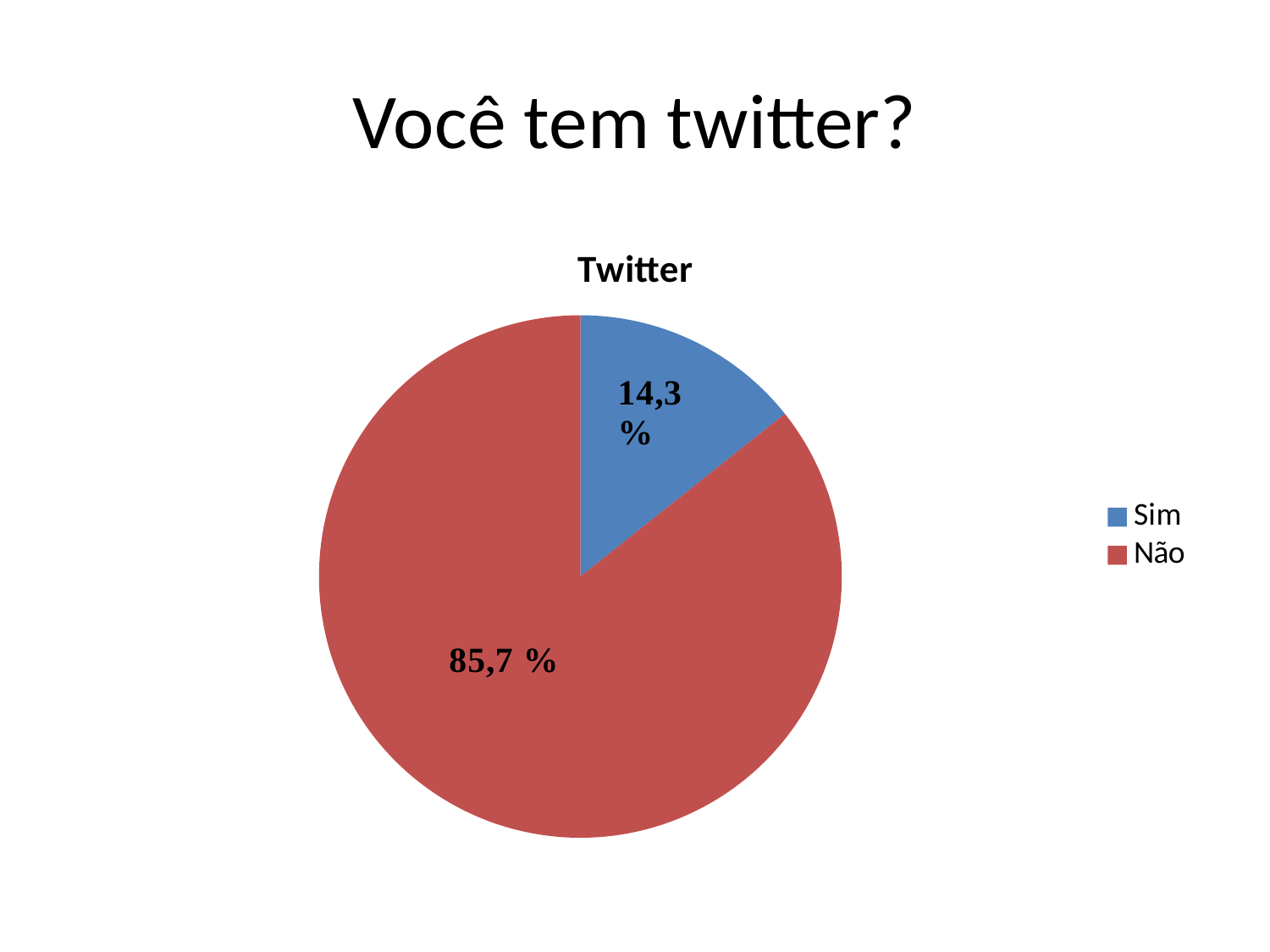
How many categories does the pie chart show? 2 Which category has the largest share of the pie? Não What is the difference in percentage points between the "Não" and "Sim" shares? 71,4 Which category has the smallest share of the pie? Sim What kind of chart is shown on the slide? Pie chart What percentage of respondents answered "Sim"? 14,3 % What is the title of the chart? Twitter Which is larger, the share for "Sim" or the share for "Não"? Não How many entries does the legend list? 2 What colour is the "Não" slice? Red What percentage of respondents answered "Não"? 85,7 %